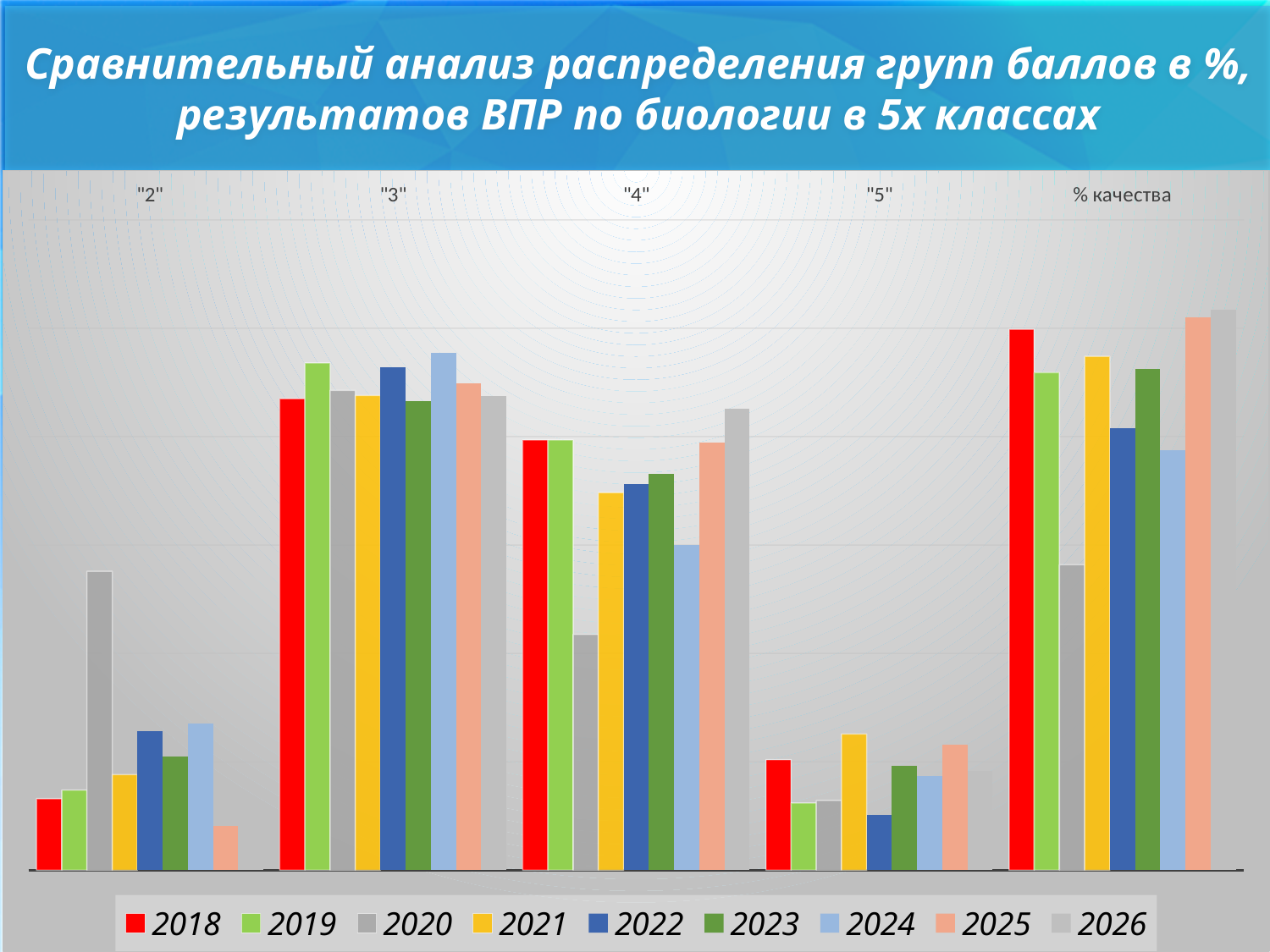
Which year has the highest value in the "2" category? 2020 What kind of chart is shown on the slide? bar chart Which year has the highest value in the "5" category? 2021 Which year has the highest value in the "4" category? 2026 Which year has the lowest value in the "% качества" category? 2020 Which year has the lowest value in the "5" category? 2022 How many categories are shown along the x axis? 5 Which year is listed first in the legend? 2018 How many series does the legend list? 9 In the "4" category, which is larger: the value for 2018 or the value for 2024? 2018 Which year has the lowest value in the "4" category? 2020